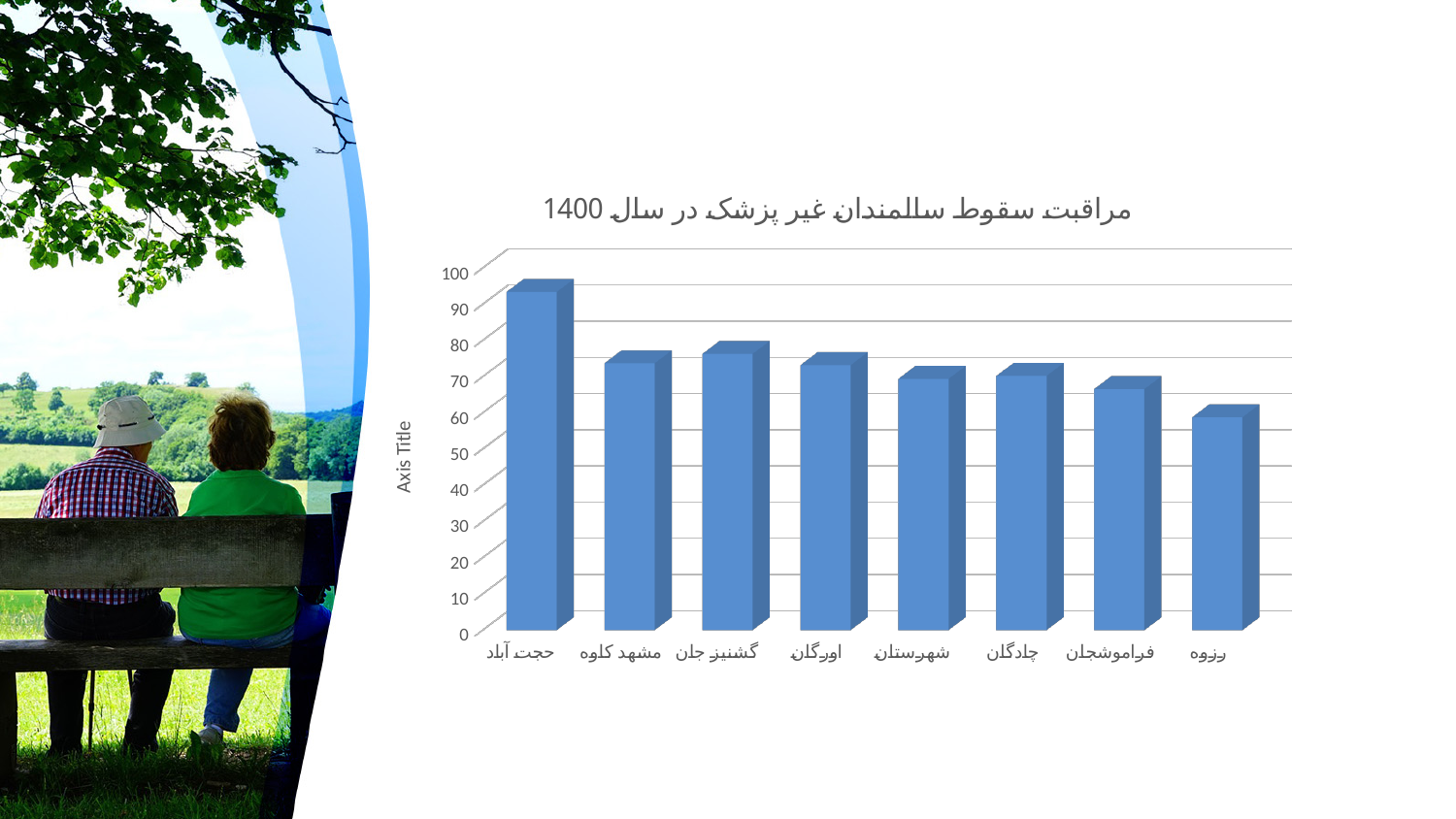
Which is larger, the value for گشنیز جان or the value for فراموشجان? گشنیز جان Is the value for حجت آباد greater or less than 80? greater Which category has the highest value? حجت آباد Is the value for گشنیز جان greater or less than 70? greater What is the title of the chart? مراقبت سقوط سالمندان غیر پزشک در سال 1400 Is the value for رزوه greater or less than 70? less How many categories are plotted on the x axis? 8 Which is larger, the value for حجت آباد or the value for رزوه? حجت آباد What label is shown on the vertical axis? Axis Title Which category has the lowest value? رزوه What kind of chart is shown on the slide? bar chart